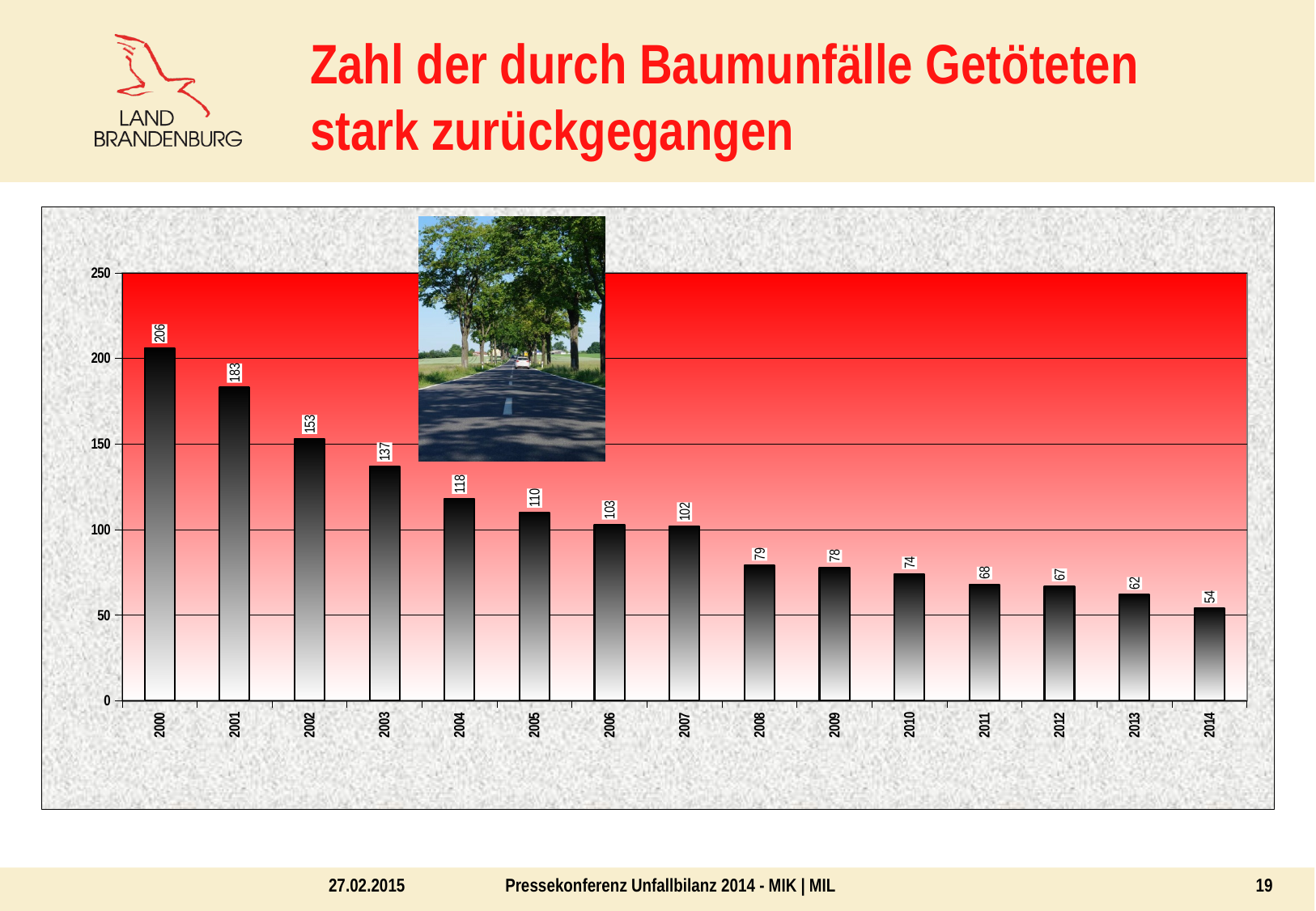
How many years are shown on the x axis? 15 Is the value for 2008 greater or less than 100? less Which year has the lowest value? 2014 Which is larger, the value for 2003 or the value for 2004? 2003 What is the value for 2007? 102 Which year has the highest value? 2000 What is the value for 2000? 206 What is the title of the slide? Zahl der durch Baumunfälle Getöteten stark zurückgegangen What kind of chart is shown? bar chart Do the values rise or fall from 2000 to 2014? fall What is the difference between the values for 2000 and 2014? 152 What is the value for 2014? 54